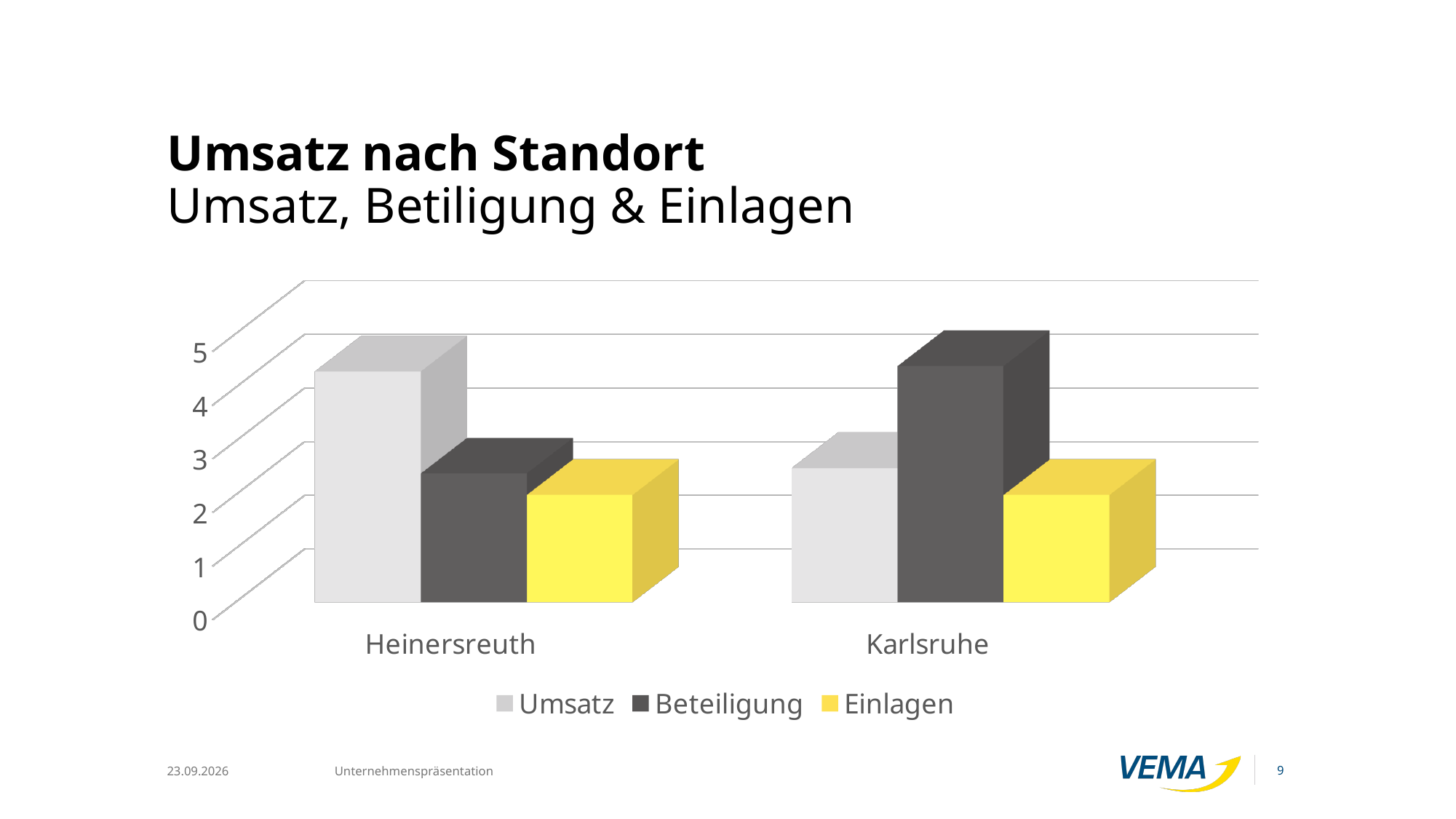
Which series has the highest value for Heinersreuth? Umsatz Which series has the highest value for Karlsruhe? Beteiligung Which series is shown in yellow in the legend? Einlagen Which location has the larger Beteiligung value, Heinersreuth or Karlsruhe? Karlsruhe Which series has the lowest value for Karlsruhe? Einlagen What kind of chart is shown on the slide? bar chart Is the Umsatz value for Heinersreuth greater or less than 3? greater Which location has the larger Umsatz value, Heinersreuth or Karlsruhe? Heinersreuth Is the Beteiligung value for Karlsruhe greater or less than 3? greater How many series does the legend list? 3 Is the Einlagen value for Heinersreuth greater or less than 3? less How many locations (categories) are shown on the x axis? 2